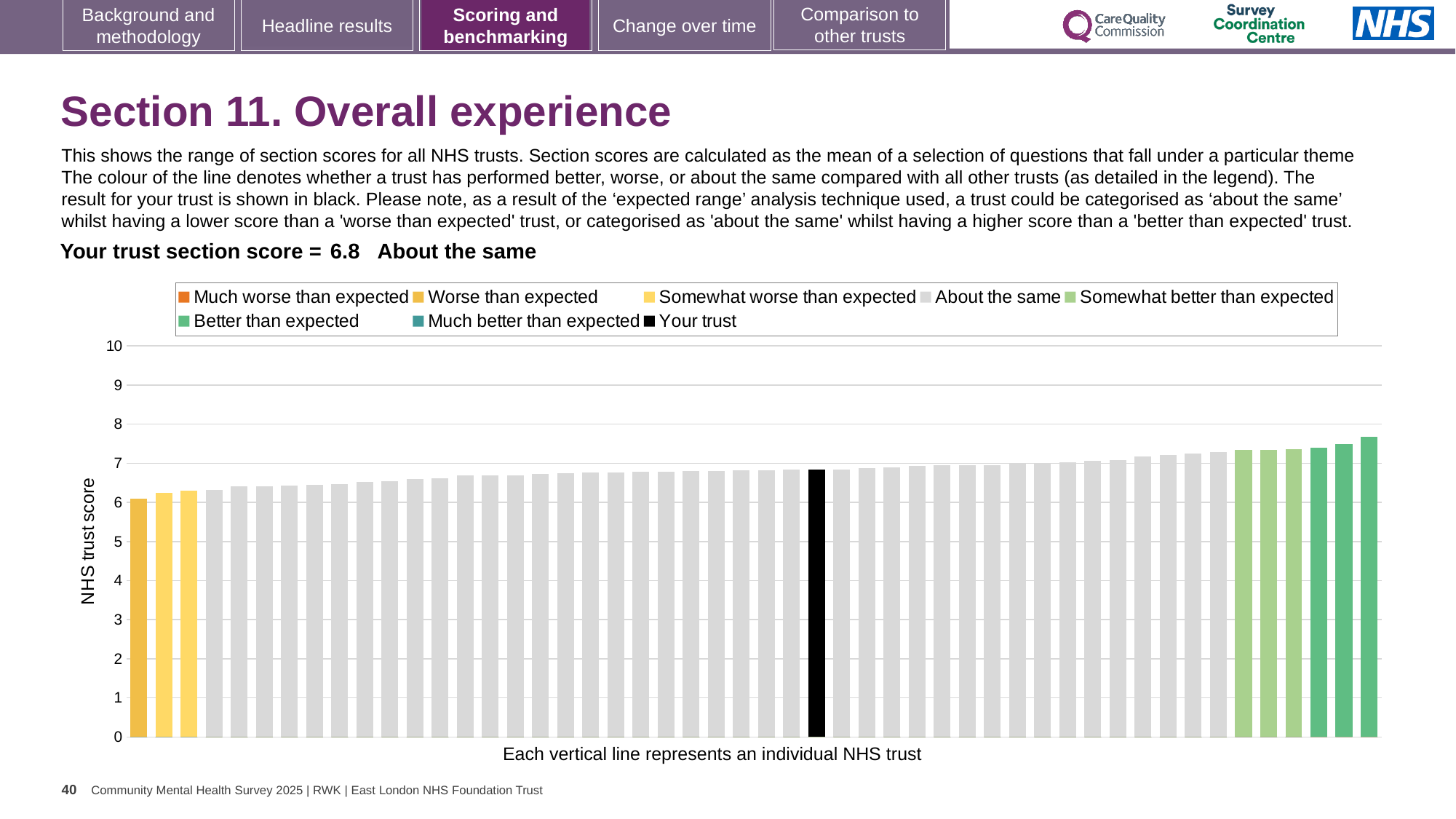
Which performance category is your trust placed in, according to the slide? About the same Do the bar values rise or fall moving from left to right along the x axis? rise Is the black 'Your trust' bar taller or shorter than the rightmost bar? shorter What is the label on the vertical axis of the chart? NHS trust score What is the section score for your trust, as printed on the slide? 6.8 Is the value of the black 'Your trust' bar greater or less than 7? less Is the value of the tallest bar (rightmost) greater or less than 8? less What kind of chart is shown on the slide? bar chart Is the value of the tallest bar (rightmost) greater or less than 7? greater How many entries does the chart legend list? 8